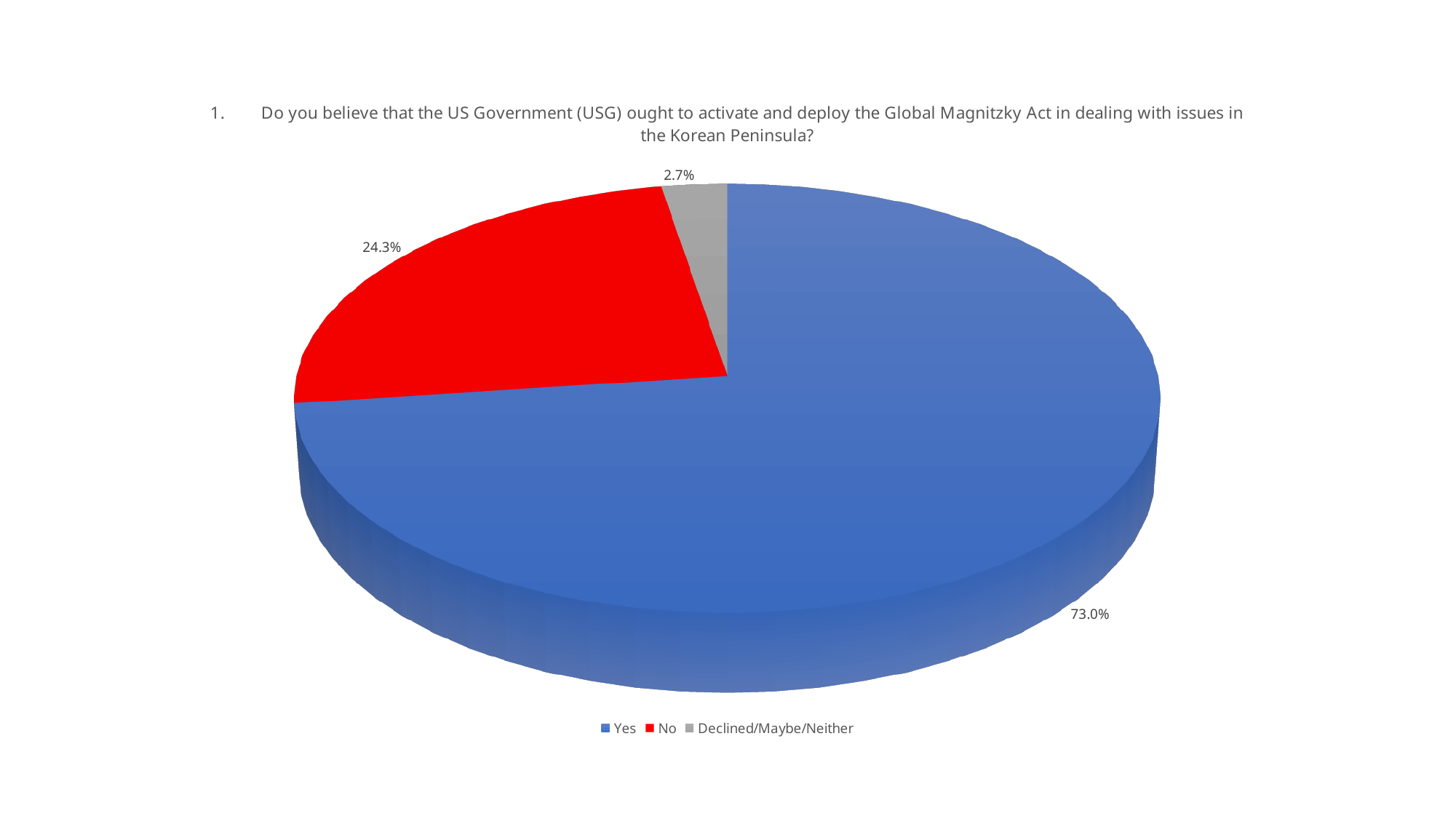
What share of the pie is labelled "Yes"? 73.0% Which slice is larger, "No" or "Declined/Maybe/Neither"? No What colour is the "No" slice? Red What is the difference in percentage points between the "No" and "Declined/Maybe/Neither" slices? 21.6 What kind of chart is shown on the slide? Pie chart Which category has the largest slice of the pie? Yes Which category has the smallest slice of the pie? Declined/Maybe/Neither What share of the pie is labelled "Declined/Maybe/Neither"? 2.7% What is the difference in percentage points between the "Yes" and "No" slices? 48.7 Which legend entry is shown in grey? Declined/Maybe/Neither What share of the pie is labelled "No"? 24.3% How many categories does the pie chart show? 3